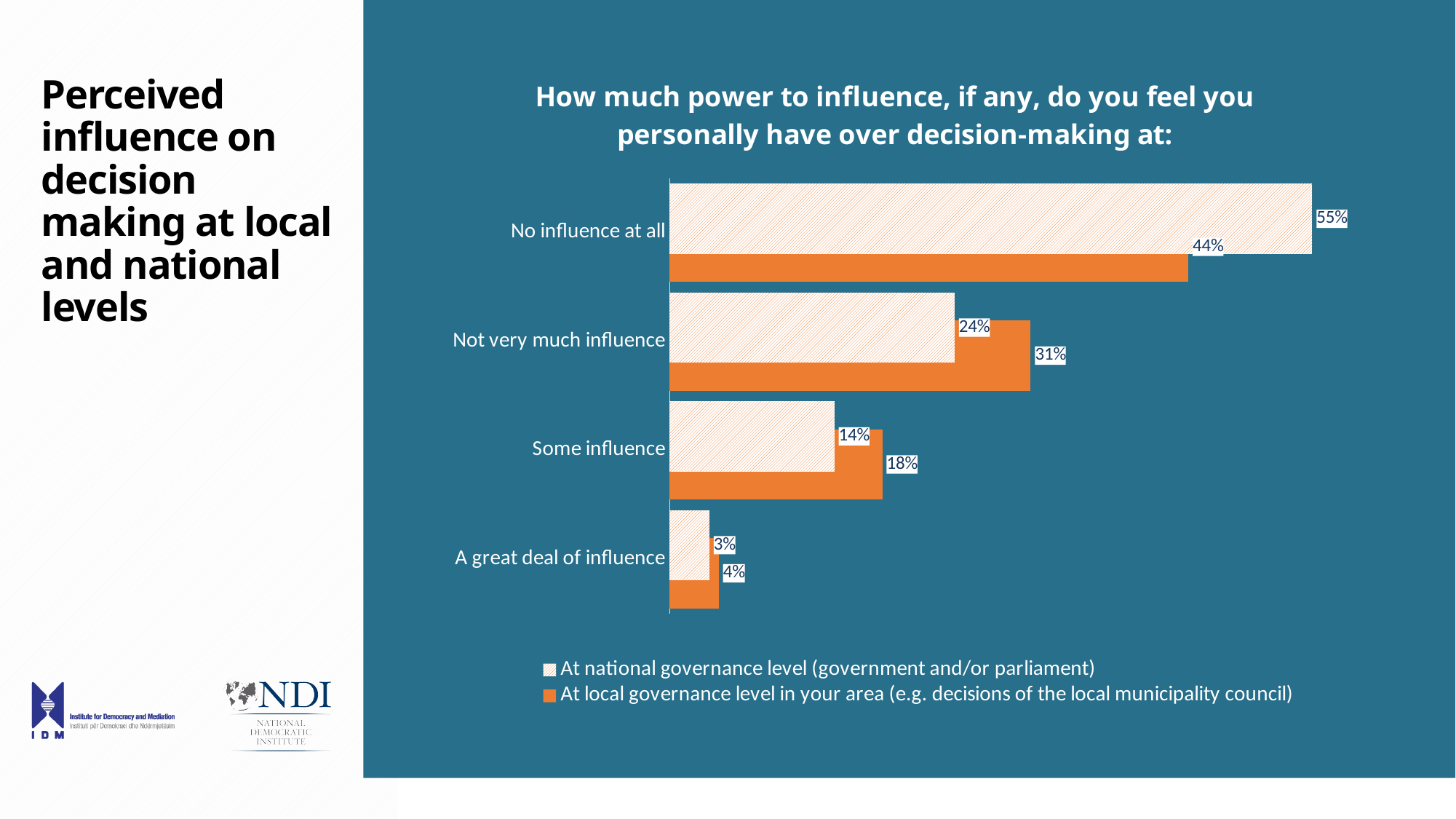
What percentage of respondents feel they have no influence at all at the local governance level? 44% For 'Some influence', which is larger: the national governance level value or the local governance level value? Local governance level Which category has the highest value for the national governance level series? No influence at all What percentage of respondents feel they have no influence at all at the national governance level? 55% What is the value for 'A great deal of influence' at the national governance level? 3% How many response categories are shown on the chart? 4 What type of chart is shown on the slide? Bar chart What is the value for 'Some influence' at the local governance level? 18% What is the difference between the national and local values for 'No influence at all'? 11 percentage points Which category has the lowest value for the local governance level series? A great deal of influence What is the difference between the local and national values for 'Not very much influence'? 7 percentage points How many series does the legend list? 2